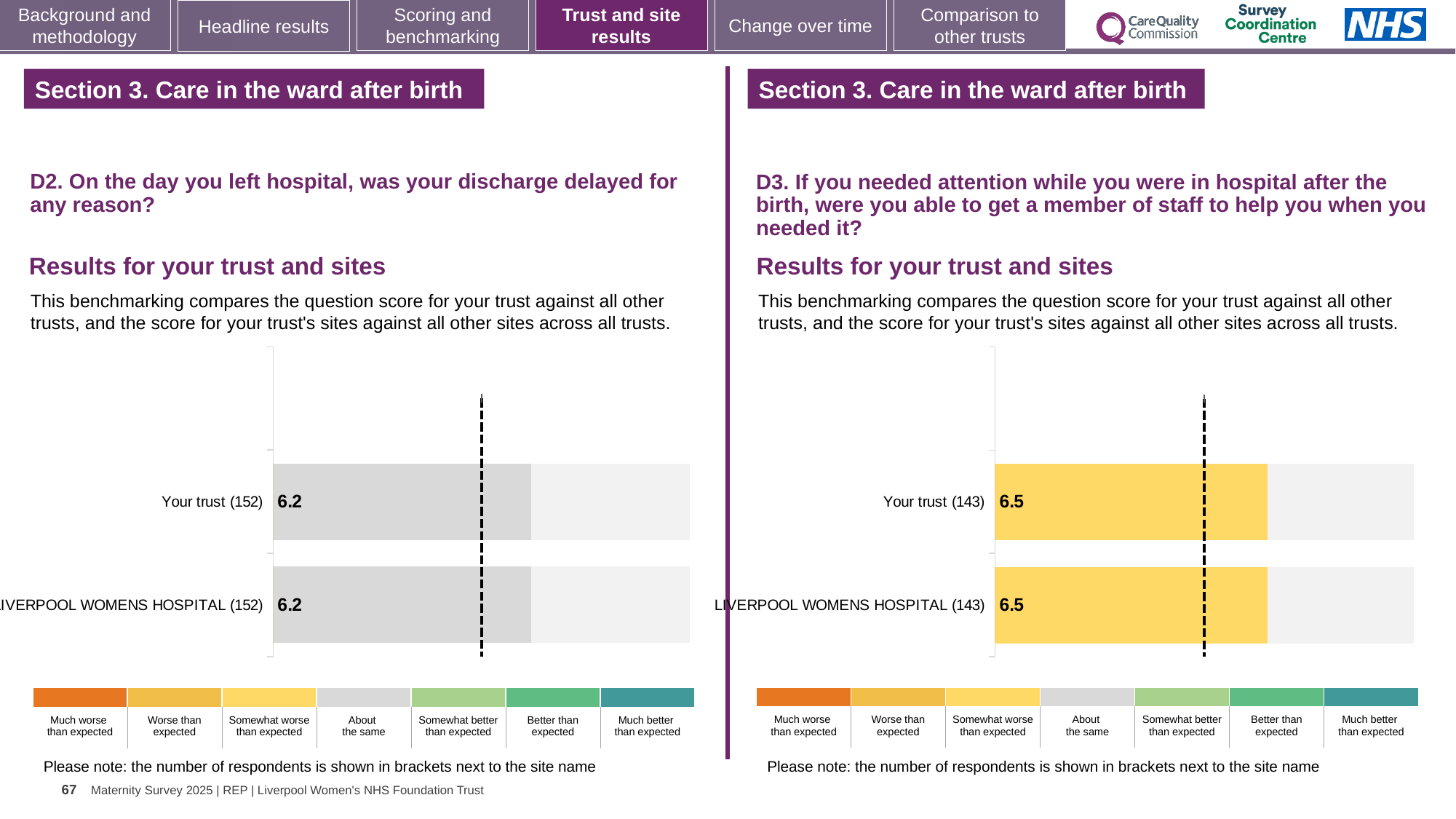
In the right chart (D3), what is the difference between the score for Your trust and the score for LIVERPOOL WOMENS HOSPITAL? 0 How many bars are plotted in the left chart (D2)? 2 How many bars are plotted in the right chart (D3)? 2 In the right chart (D3, able to get a member of staff to help), what is the score for Your trust? 6.5 In the right chart (D3, able to get a member of staff to help), what is the score for LIVERPOOL WOMENS HOSPITAL? 6.5 In the left chart (D2), how many respondents are shown in brackets for Your trust? 152 According to the colour key, which benchmarking category do the yellow bars in the right chart (D3) represent? Somewhat worse than expected In the right chart (D3), how many respondents are shown in brackets for LIVERPOOL WOMENS HOSPITAL? 143 In the left chart (D2, discharge delayed), what is the score for LIVERPOOL WOMENS HOSPITAL? 6.2 In the left chart (D2), what is the difference between the score for Your trust and the score for LIVERPOOL WOMENS HOSPITAL? 0 What type of chart is used in the left chart (D2)? Bar chart In the left chart (D2, discharge delayed), what is the score for Your trust? 6.2